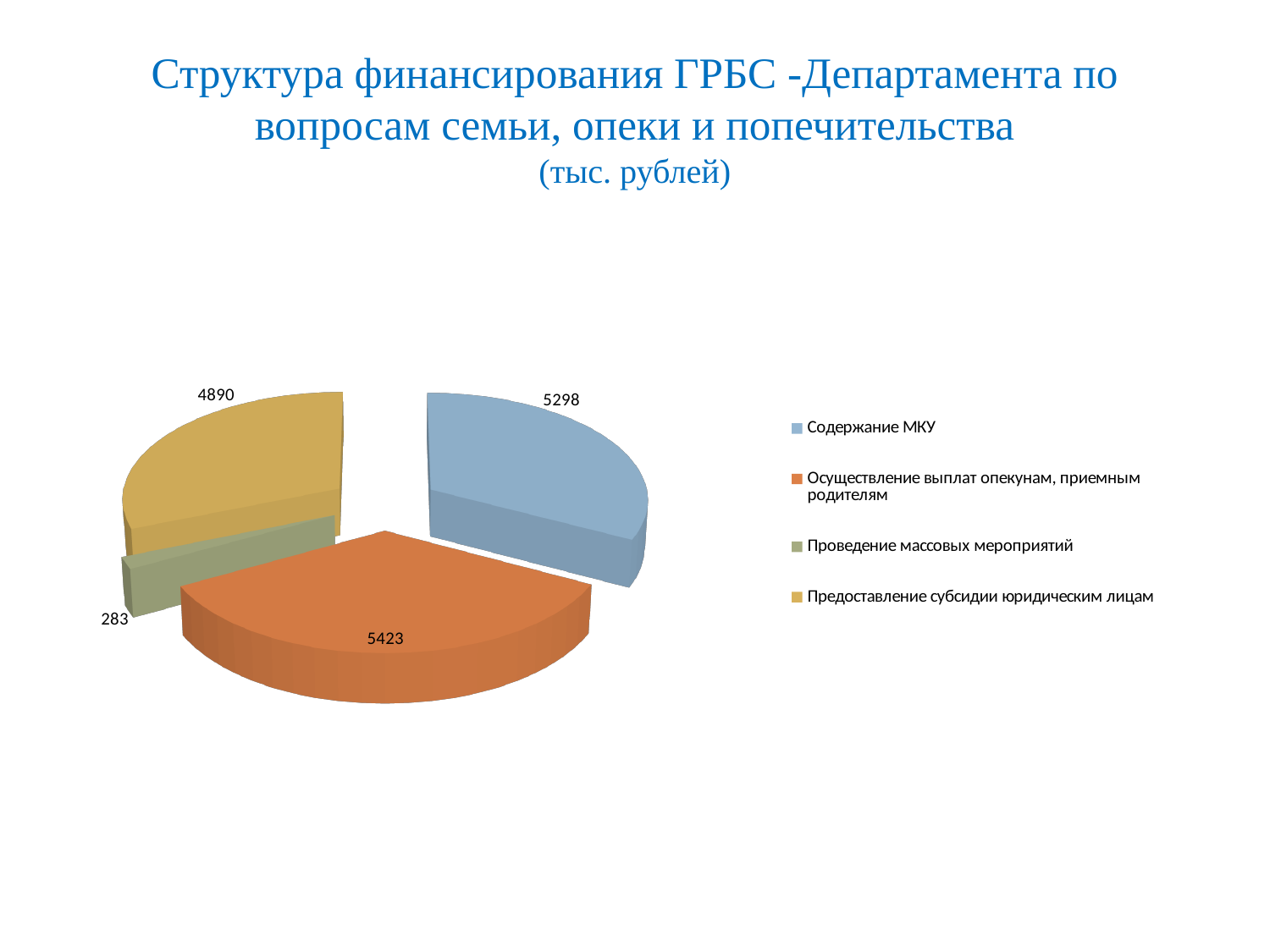
What is the value for Осуществление выплат опекунам, приемным родителям? 5423 Which category has the largest value? Осуществление выплат опекунам, приемным родителям What kind of chart is shown on the slide? Pie chart What is the value for Проведение массовых мероприятий? 283 What is the value for Предоставление субсидии юридическим лицам? 4890 Which is larger: the value for Содержание МКУ or the value for Предоставление субсидии юридическим лицам? Содержание МКУ How many categories does the pie chart have? 4 What is the total of all the slices in the pie chart? 15894 What is the difference between the values for Осуществление выплат опекунам, приемным родителям and Содержание МКУ? 125 What is the value for Содержание МКУ? 5298 Which category has the smallest value? Проведение массовых мероприятий What is the difference between the values for Содержание МКУ and Предоставление субсидии юридическим лицам? 408